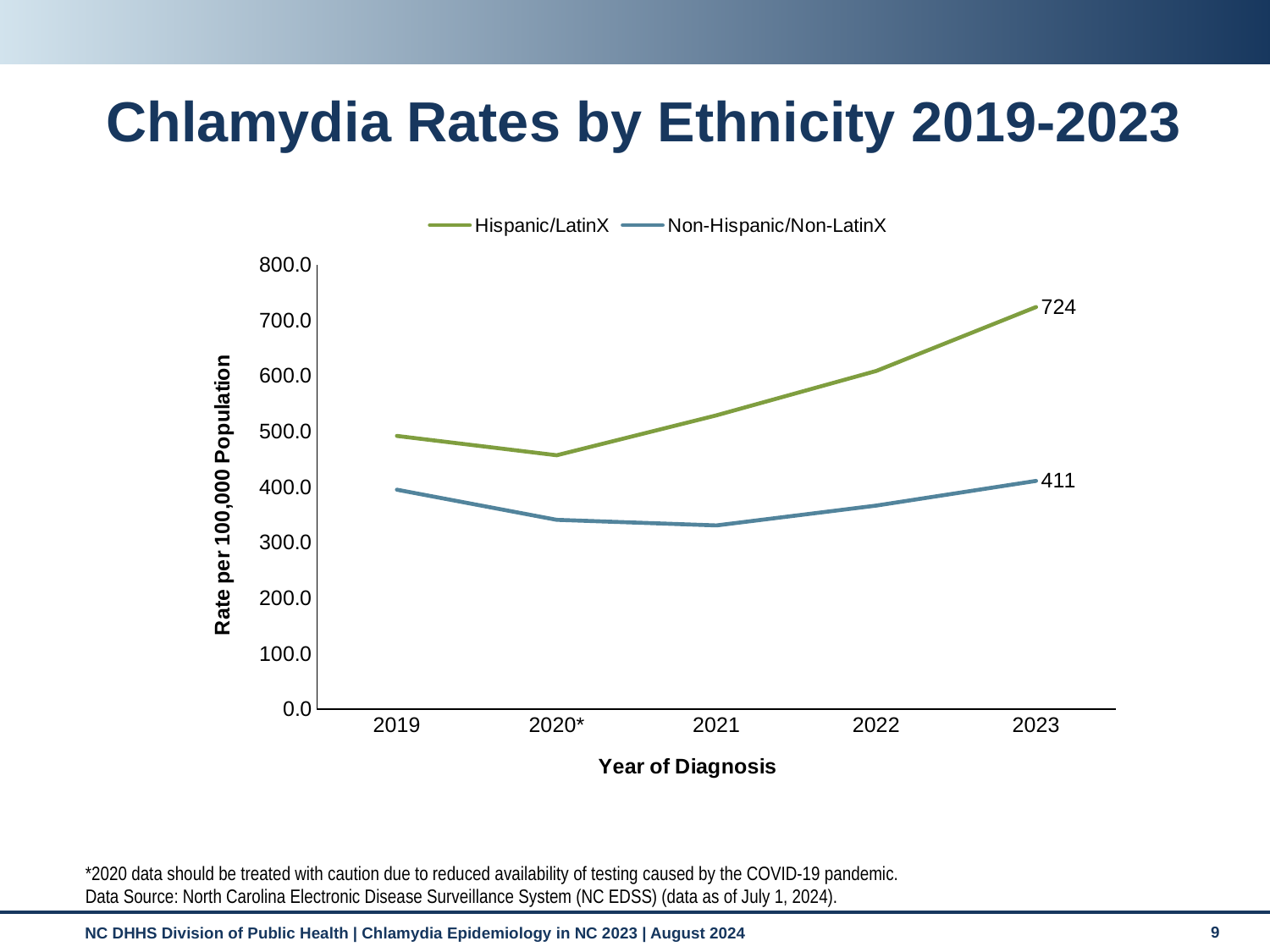
Which series has the higher rate in 2023, Hispanic/LatinX or Non-Hispanic/Non-LatinX? Hispanic/LatinX Does the Hispanic/LatinX rate rise or fall from 2020* to 2023? Rise What is the difference between the Hispanic/LatinX and Non-Hispanic/Non-LatinX rates in 2023? 313 What is the Hispanic/LatinX chlamydia rate in 2023? 724 How many series does the legend list? 2 In which year is the Non-Hispanic/Non-LatinX rate lowest? 2021 How many years are shown on the x axis? 5 What is the Non-Hispanic/Non-LatinX chlamydia rate in 2023? 411 Is the Hispanic/LatinX rate in 2019 greater or less than 400.0? greater In which year is the Hispanic/LatinX rate highest? 2023 Is the Non-Hispanic/Non-LatinX rate in 2021 greater or less than 400.0? less What kind of chart is shown on the slide? Line chart